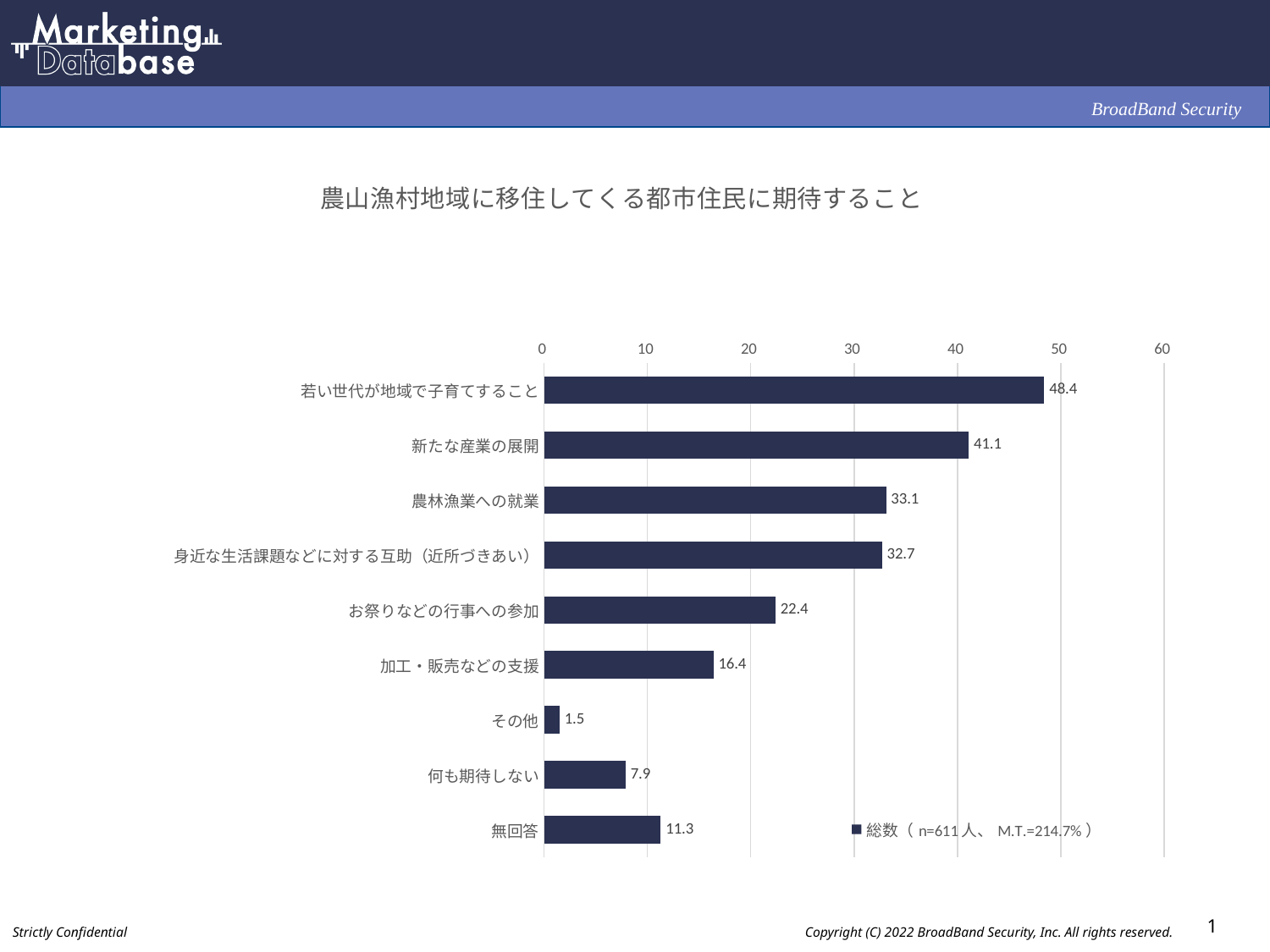
Is the value for 身近な生活課題などに対する互助（近所づきあい） greater or less than 30? greater Which category has the lowest value? その他 What is the value for 無回答? 11.3 What kind of chart is shown on the slide? bar chart What is the difference between the values for 新たな産業の展開 and 農林漁業への就業? 8.0 How many series does the legend list? 1 How many categories are shown in the chart? 9 Which is larger, the value for お祭りなどの行事への参加 or the value for 何も期待しない? お祭りなどの行事への参加 What is the value for 若い世代が地域で子育てすること? 48.4 What is the value for 加工・販売などの支援? 16.4 What is the title of the chart? 農山漁村地域に移住してくる都市住民に期待すること Which category has the highest value? 若い世代が地域で子育てすること